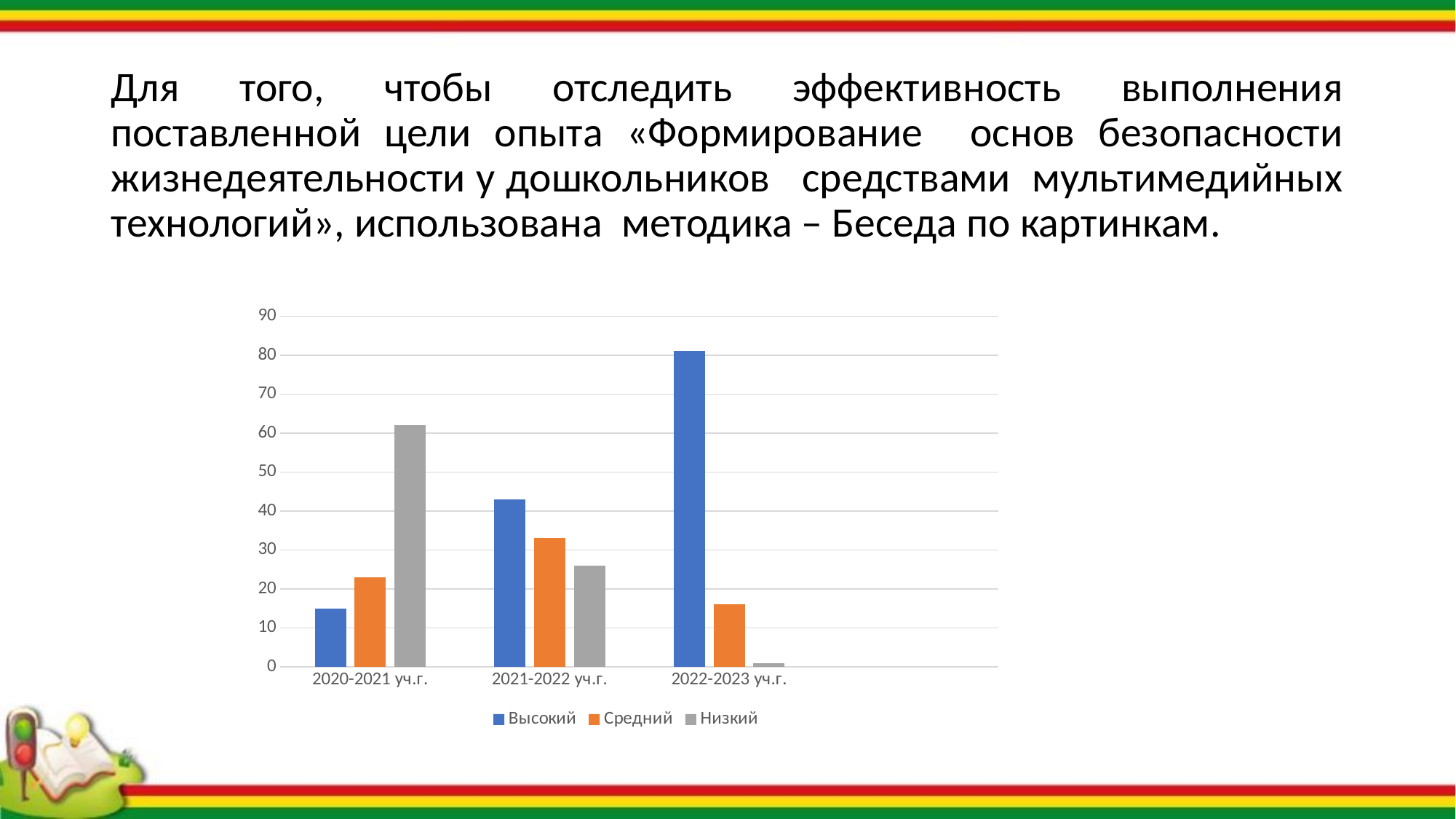
How many categories (academic years) are shown on the x axis? 3 Which series is shown in blue in the legend? Высокий Does the Высокий series rise or fall across the academic years from 2020-2021 to 2022-2023? rise Is the value for Высокий in 2020-2021 уч.г. greater or less than 20? less In which academic year is the Низкий series lowest? 2022-2023 уч.г. In which academic year is the Высокий series highest? 2022-2023 уч.г. Is the value for Низкий in 2020-2021 уч.г. greater or less than 60? greater What kind of chart is shown on the slide? bar chart Which series is shown in grey in the legend? Низкий How many series does the legend list? 3 Is the value for Средний in 2021-2022 уч.г. greater or less than 30? greater